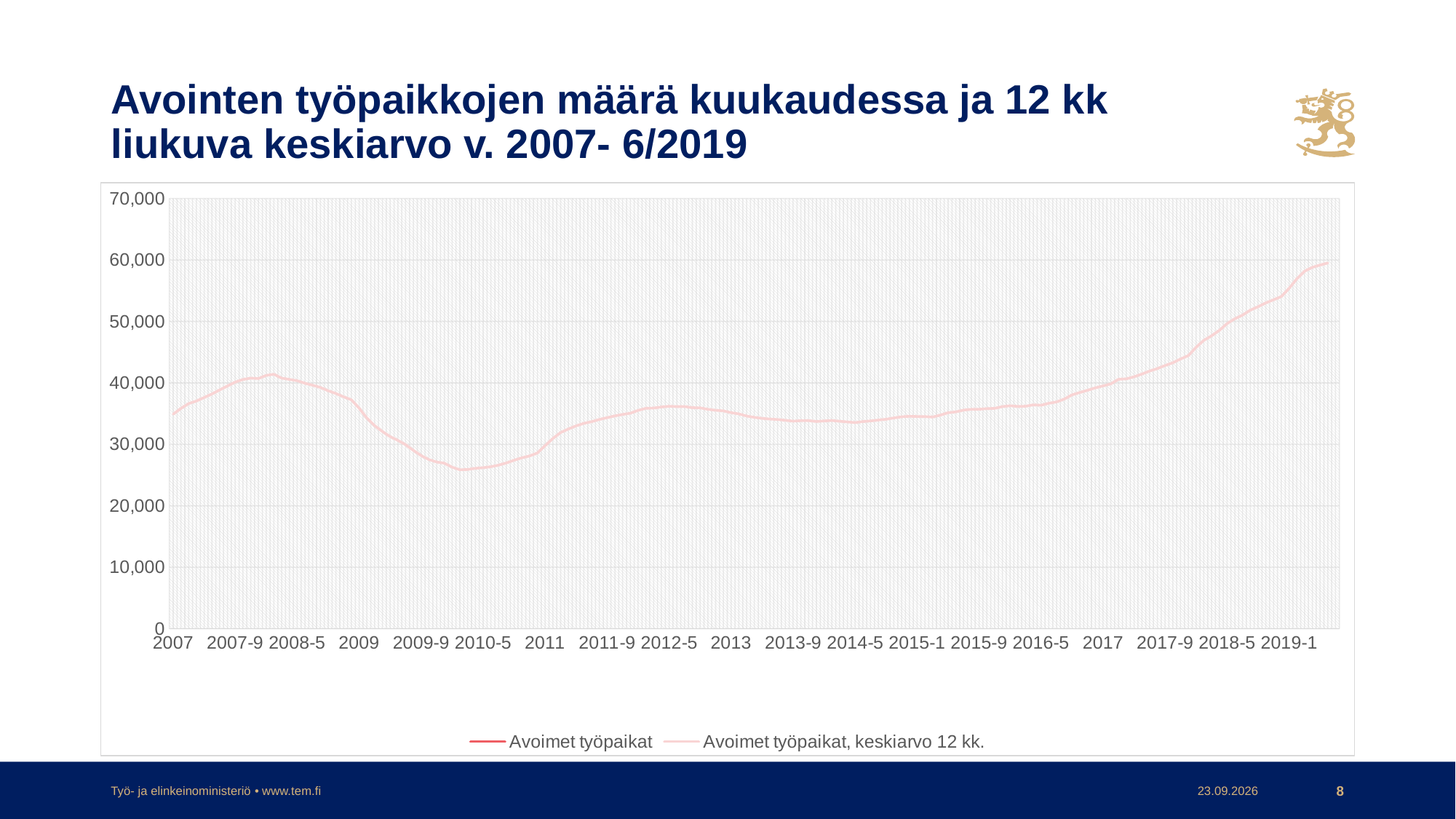
Around which x-axis label does the plotted line reach its lowest value? 2010-5 What kind of chart is shown on the slide? line chart Is the value of the plotted line at 2007 greater or less than 30,000? greater Does the plotted line rise or fall between 2008-5 and 2010-5? fall How many series does the chart legend list? 2 What is the title of the slide containing the chart? Avointen työpaikkojen määrä kuukaudessa ja 12 kk liukuva keskiarvo v. 2007- 6/2019 Is the value of the plotted line at 2013 greater or less than 40,000? less Does the plotted line rise or fall between 2017 and 2019-1? rise Is the value of the plotted line at 2019-1 greater or less than 50,000? greater What is the second series named in the chart legend? Avoimet työpaikat, keskiarvo 12 kk. Which is larger, the value of the plotted line at 2019-1 or at 2007? 2019-1